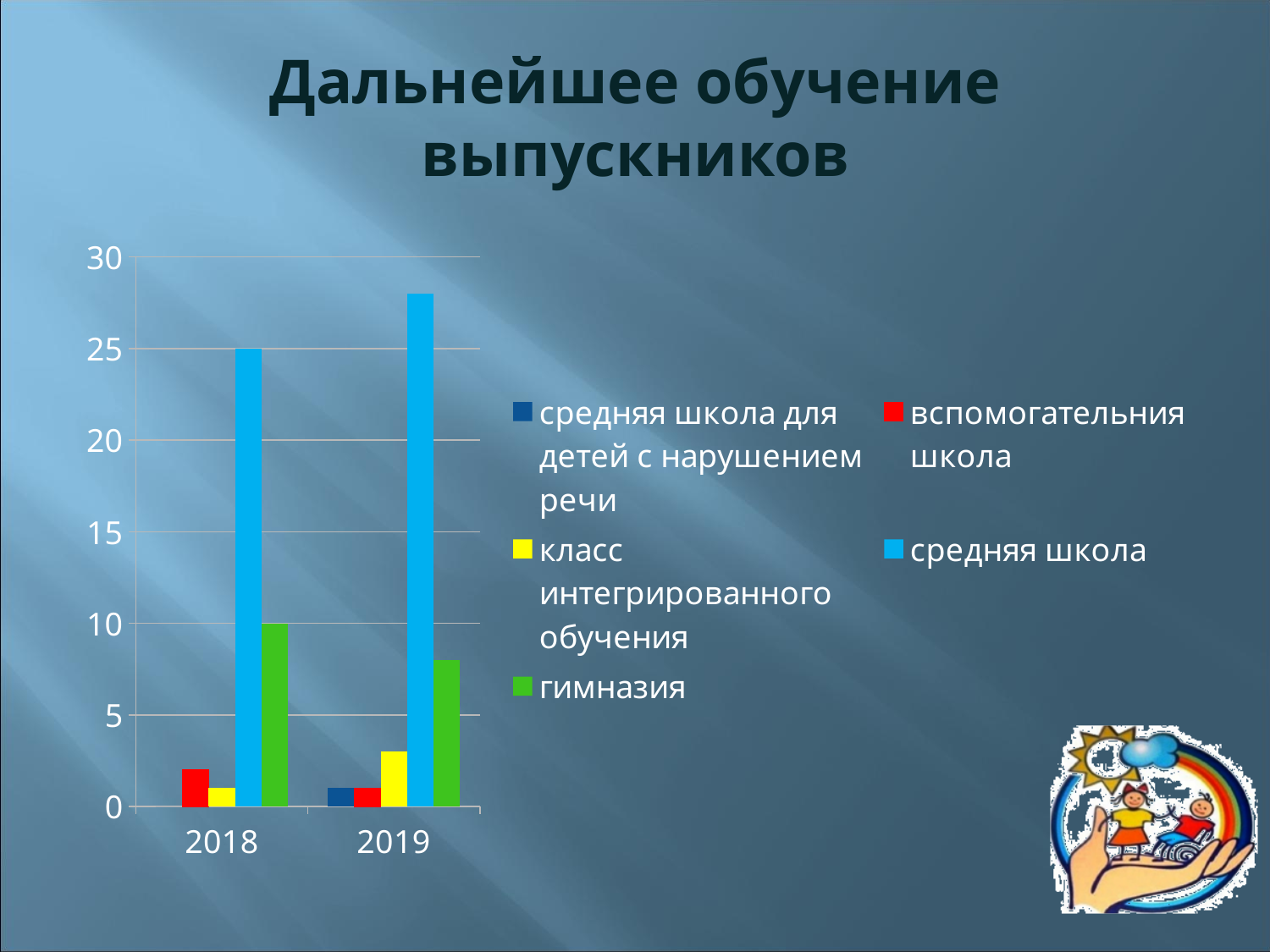
How many categories (years) are shown on the x axis of the chart? 2 Which series has the highest value in 2019? средняя школа Is the value for гимназия in 2019 greater or less than 10? less Which year has the larger value for гимназия, 2018 or 2019? 2018 What is the title of the slide containing the chart? Дальнейшее обучение выпускников How many series does the chart's legend list? 5 What is the value for гимназия in 2018? 10 Is the value for средняя школа in 2019 greater or less than 25? greater Does the value for средняя школа rise or fall from 2018 to 2019? rises Is the value for класс интегрированного обучения in 2019 greater or less than 5? less What kind of chart is shown on the slide? bar chart What is the value for средняя школа in 2018? 25